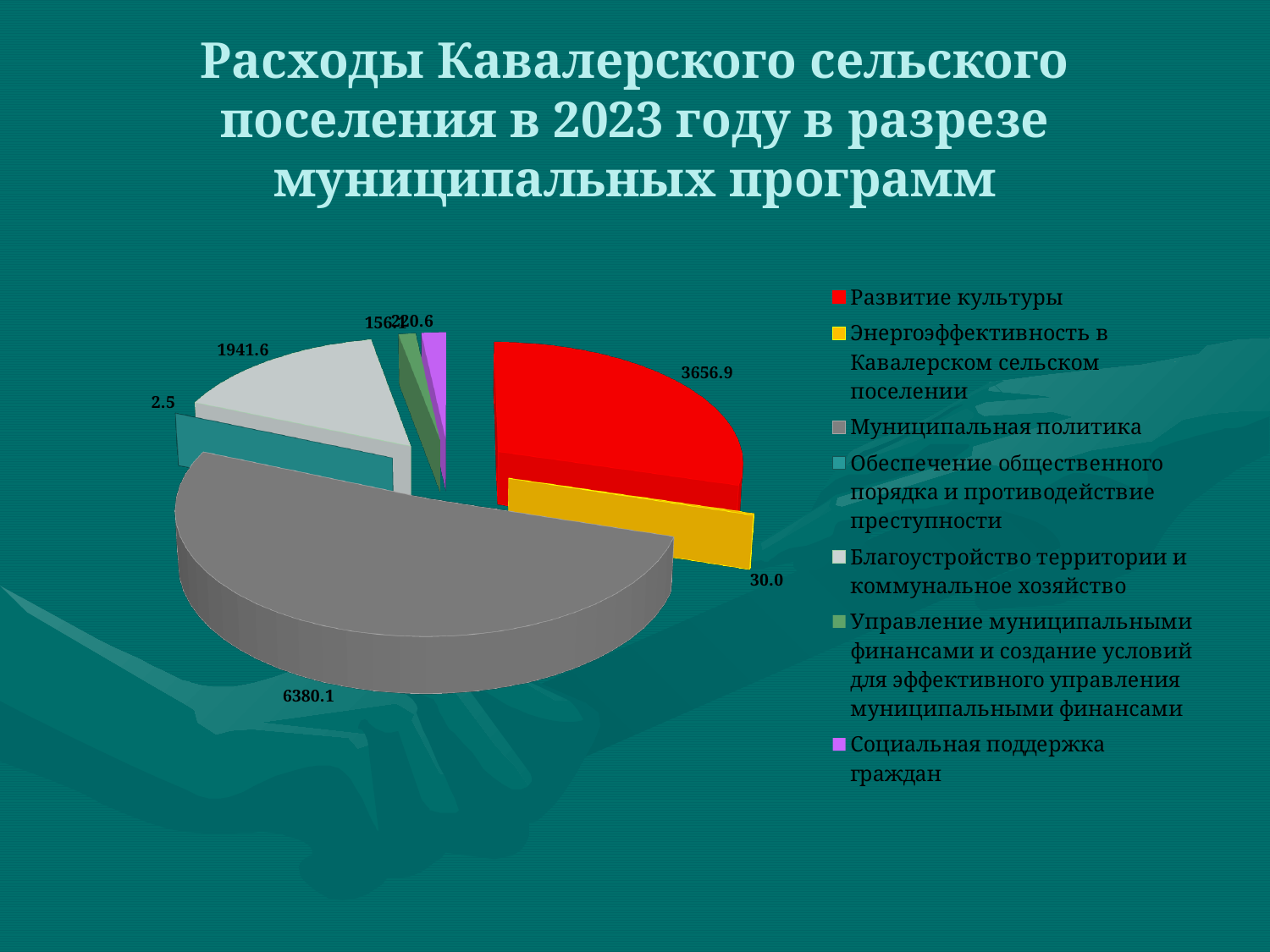
What colour is the slice for Развитие культуры? red What is the value for Энергоэффективность в Кавалерском сельском поселении? 30.0 What is the value for Благоустройство территории и коммунальное хозяйство? 1941.6 What is the value for Муниципальная политика? 6380.1 What is the value for Развитие культуры? 3656.9 Which category has the smallest value? Обеспечение общественного порядка и противодействие преступности What is the value for Обеспечение общественного порядка и противодействие преступности? 2.5 Which category has the largest slice of the pie? Муниципальная политика How many slices does the pie chart have? 7 What is the difference between the values for Муниципальная политика and Развитие культуры? 2723.2 What kind of chart is shown on the slide? pie chart Which is larger: the value for Развитие культуры or the value for Благоустройство территории и коммунальное хозяйство? Развитие культуры